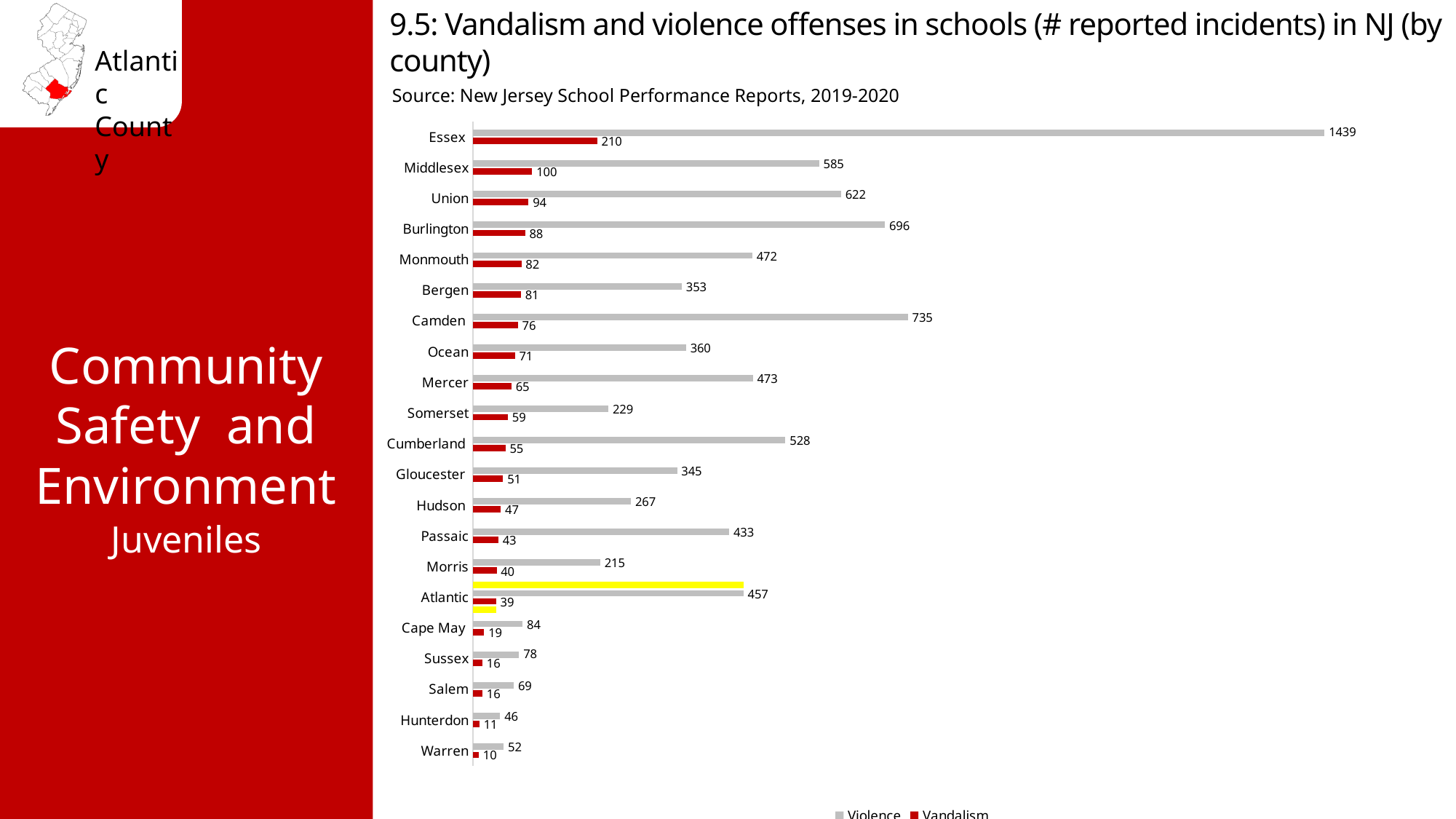
What is the number of reported vandalism incidents for Hunterdon County? 11 What is the difference between the violence incidents in Camden and Burlington? 39 How many counties are shown in the chart? 21 What is the number of reported vandalism incidents for Essex County? 210 What kind of chart is shown on the slide? Bar chart What is the number of reported violence incidents for Atlantic County? 457 Which series is shown in red in the chart? Vandalism What is the difference between the vandalism incidents in Middlesex and Union? 6 Which county has the highest number of reported violence incidents? Essex How many series does the legend list? 2 Which county has the lowest number of reported vandalism incidents? Warren Which county has more reported violence incidents, Mercer or Monmouth? Mercer